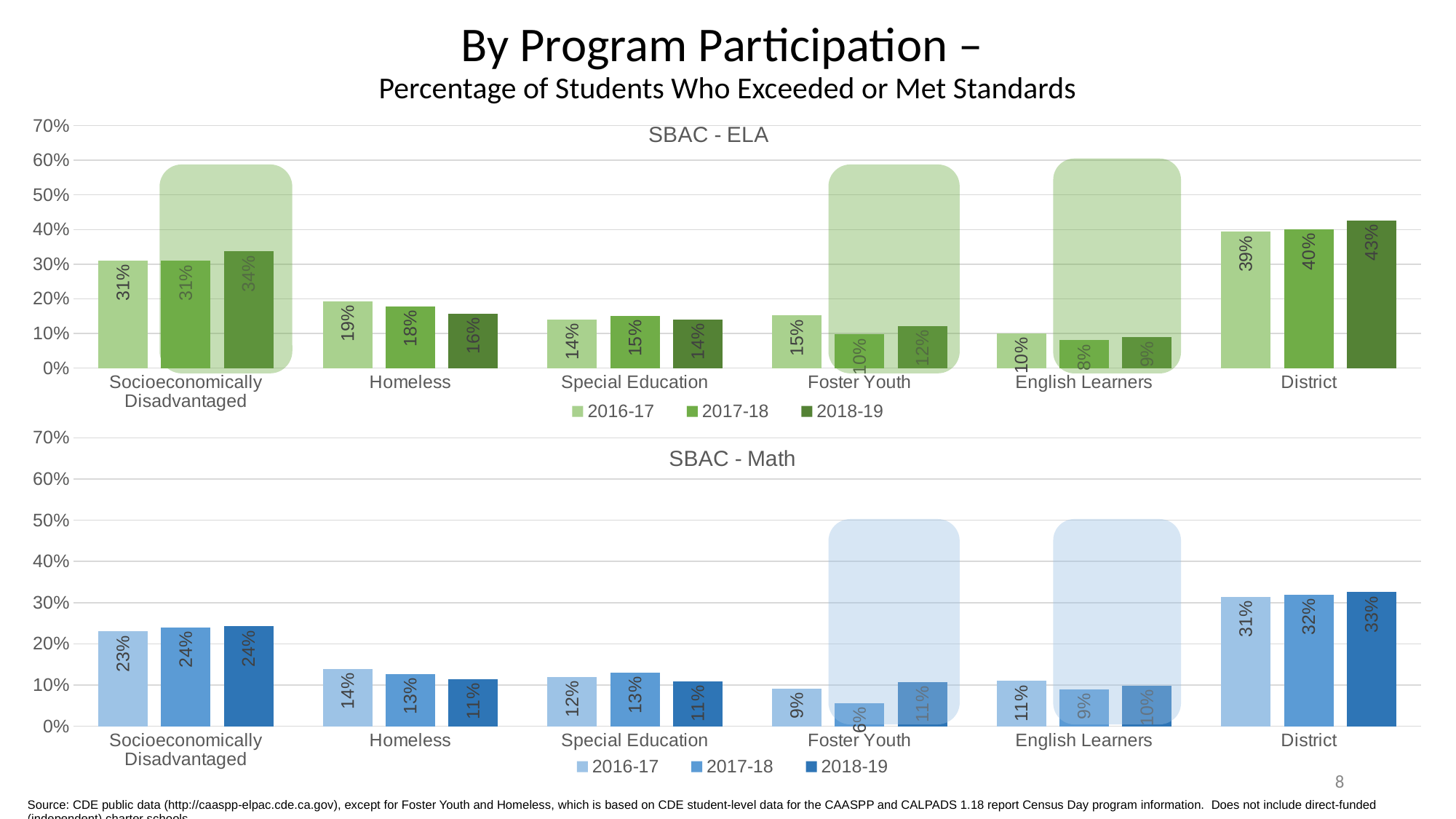
In the SBAC - ELA chart, which category has the lowest value in 2017-18? English Learners In the SBAC - ELA chart, what is the value for English Learners in 2017-18? 8% In the SBAC - Math chart, which is larger for Homeless: the 2016-17 value or the 2018-19 value? 2016-17 How many series does the legend of the SBAC - ELA chart list? 3 In the SBAC - ELA chart, what is the difference between the 2018-19 and 2016-17 values for Socioeconomically Disadvantaged? 3% In the SBAC - Math chart, which category has the highest value in 2018-19? District In the SBAC - ELA chart, do the values for District rise or fall from 2016-17 to 2018-19? Rise What are the three series listed in the legend of the SBAC - Math chart? 2016-17, 2017-18, 2018-19 In the SBAC - Math chart, what is the value for Foster Youth in 2017-18? 6% What kind of chart is the SBAC - Math chart? Bar chart In the SBAC - ELA chart, what is the value for District in 2018-19? 43% How many categories are shown on the x axis of the SBAC - Math chart? 6